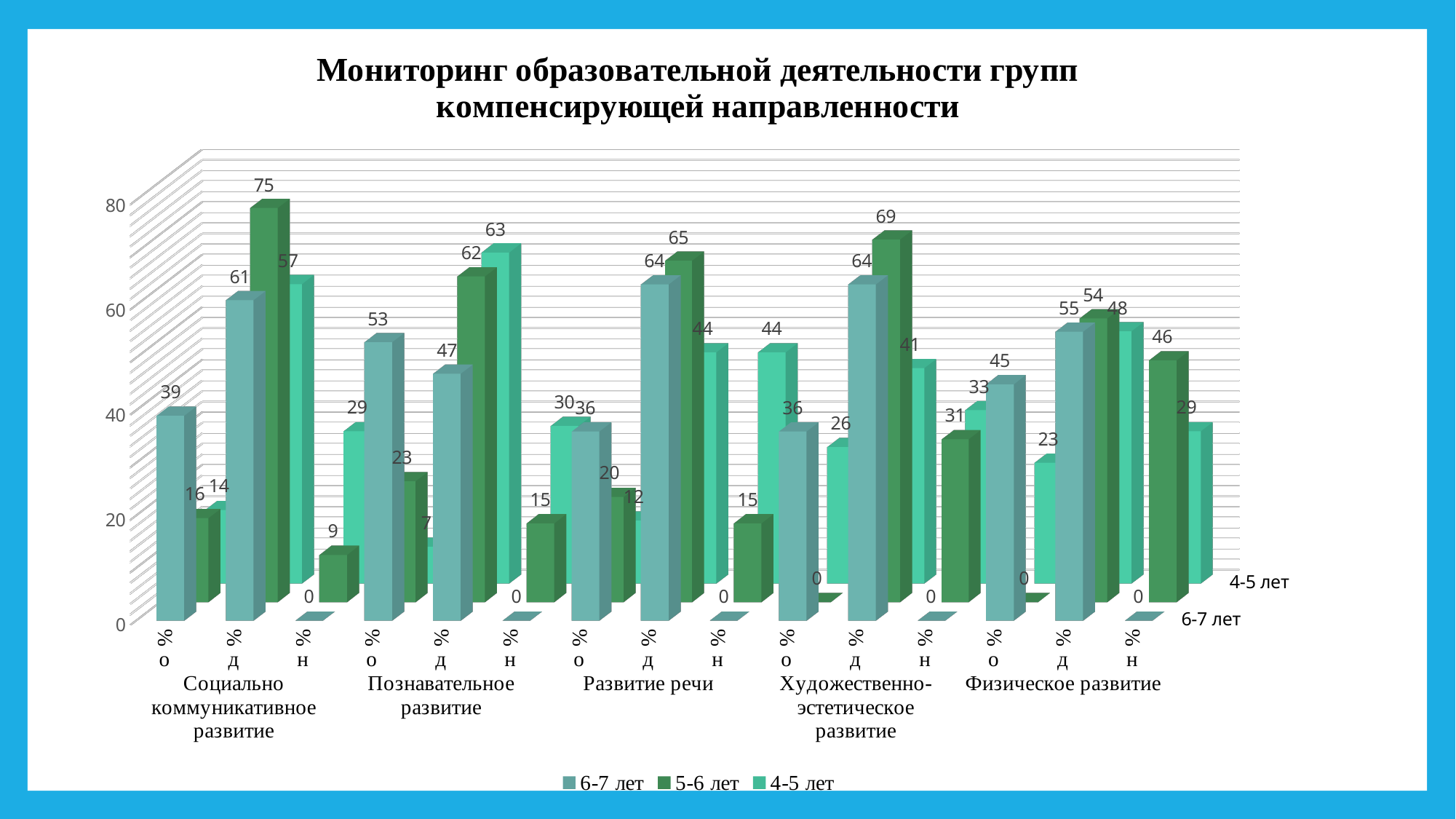
What is the highest value shown anywhere on the chart? 75 What is the value for 5-6 лет at %д in Социально коммуникативное развитие? 75 What are the series names listed in the legend? 6-7 лет, 5-6 лет, 4-5 лет At %о in Познавательное развитие, which series has the larger value: 6-7 лет or 5-6 лет? 6-7 лет Is the value for 5-6 лет at %д in Познавательное развитие greater or less than 40? greater How many educational areas (main category groups) are shown along the x axis? 5 What is the value for 5-6 лет at %д in Художественно-эстетическое развитие? 69 What is the difference between the 5-6 лет value (75) and the 6-7 лет value (61) at %д in Социально коммуникативное развитие? 14 What kind of chart is shown on the slide? bar chart What is the value for 6-7 лет at %о in Социально коммуникативное развитие? 39 What is the title of the chart? Мониторинг образовательной деятельности групп компенсирующей направленности How many series does the legend list? 3